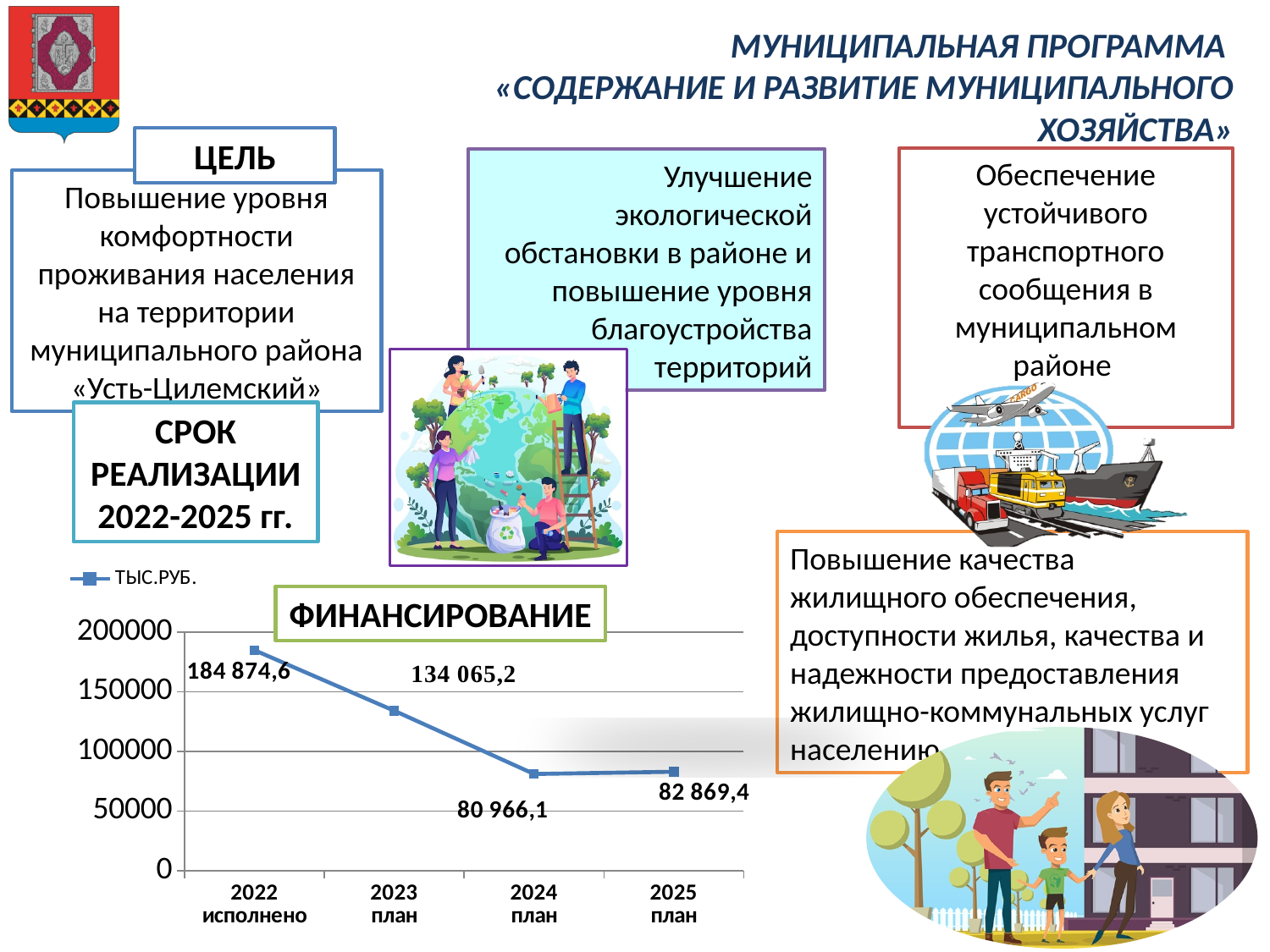
Which is larger in the ФИНАНСИРОВАНИЕ chart: the value for 2024 план or 2025 план? 2025 план Which year has the highest value in the ФИНАНСИРОВАНИЕ chart? 2022 исполнено What is the difference between the values for 2022 исполнено and 2023 план in the ФИНАНСИРОВАНИЕ chart? 50 809,4 What is the value for 2023 план in the ФИНАНСИРОВАНИЕ chart? 134 065,2 Which year has the lowest value in the ФИНАНСИРОВАНИЕ chart? 2024 план What is the value for 2022 исполнено in the ФИНАНСИРОВАНИЕ chart? 184 874,6 What type of chart is shown under the heading ФИНАНСИРОВАНИЕ? line chart What is the value for 2025 план in the ФИНАНСИРОВАНИЕ chart? 82 869,4 How many data points are plotted in the ФИНАНСИРОВАНИЕ chart? 4 What is the value for 2024 план in the ФИНАНСИРОВАНИЕ chart? 80 966,1 What unit does the legend of the ФИНАНСИРОВАНИЕ chart show? ТЫС.РУБ. Does the value in the ФИНАНСИРОВАНИЕ chart rise or fall from 2022 to 2024? fall